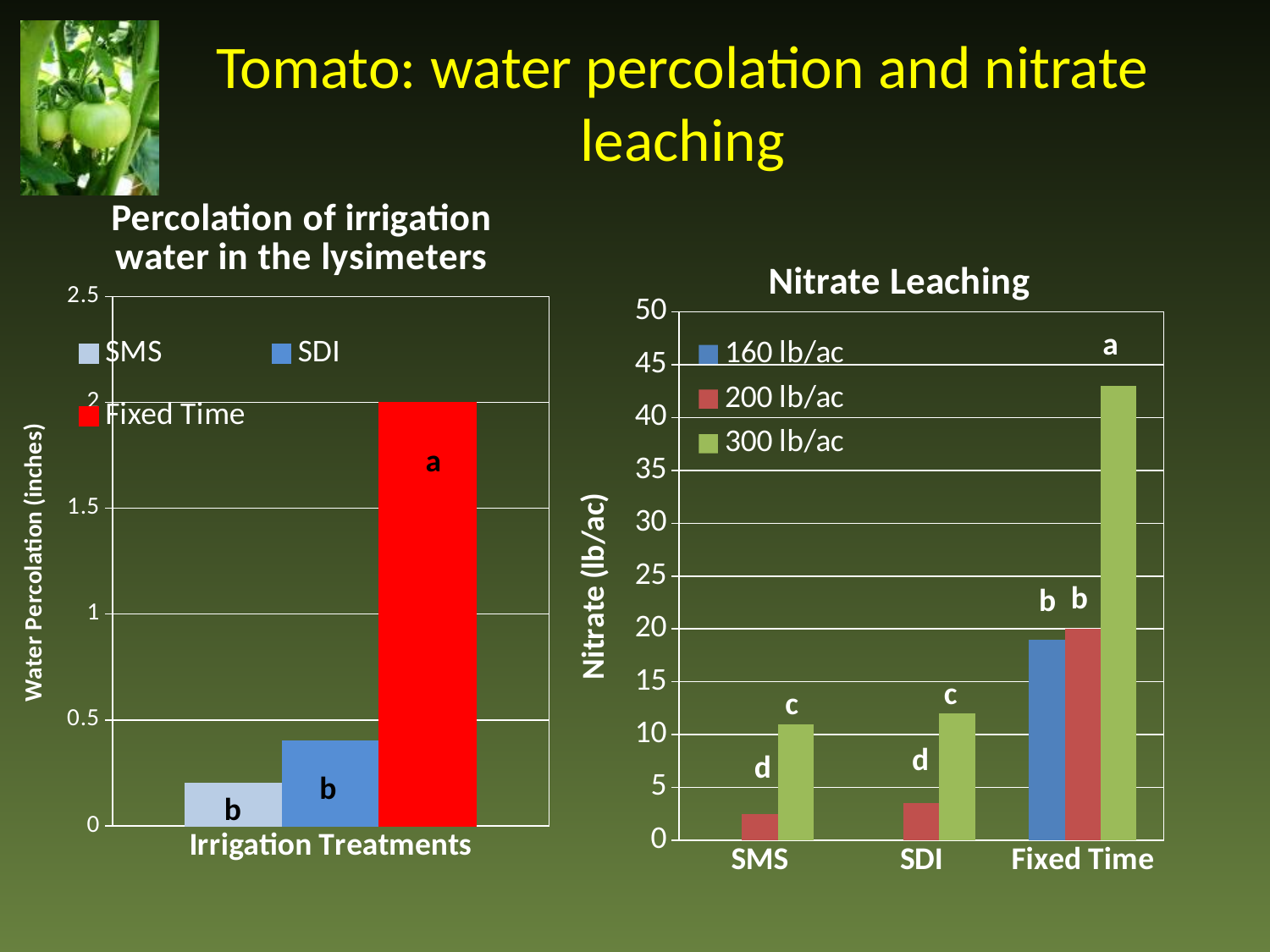
What type of chart is the 'Percolation of irrigation water in the lysimeters' chart? bar chart In the 'Nitrate Leaching' chart, which irrigation treatment has the highest nitrate value for the 300 lb/ac series? Fixed Time In the 'Nitrate Leaching' chart, which is larger for Fixed Time: the 160 lb/ac value or the 300 lb/ac value? 300 lb/ac In the 'Percolation of irrigation water in the lysimeters' chart, is the value for SDI greater or less than 0.5? less In the 'Nitrate Leaching' chart, is the 300 lb/ac value for SMS greater or less than 15? less In the 'Nitrate Leaching' chart, is the 300 lb/ac value for Fixed Time greater or less than 40? greater How many irrigation treatment categories are shown on the x axis of the 'Nitrate Leaching' chart? 3 In the 'Percolation of irrigation water in the lysimeters' chart, which irrigation treatment has the highest water percolation? Fixed Time How many series does the legend of the 'Percolation of irrigation water in the lysimeters' chart list? 3 What is the y-axis title of the 'Percolation of irrigation water in the lysimeters' chart? Water Percolation (inches) In the 'Percolation of irrigation water in the lysimeters' chart, which irrigation treatment has the lowest water percolation? SMS